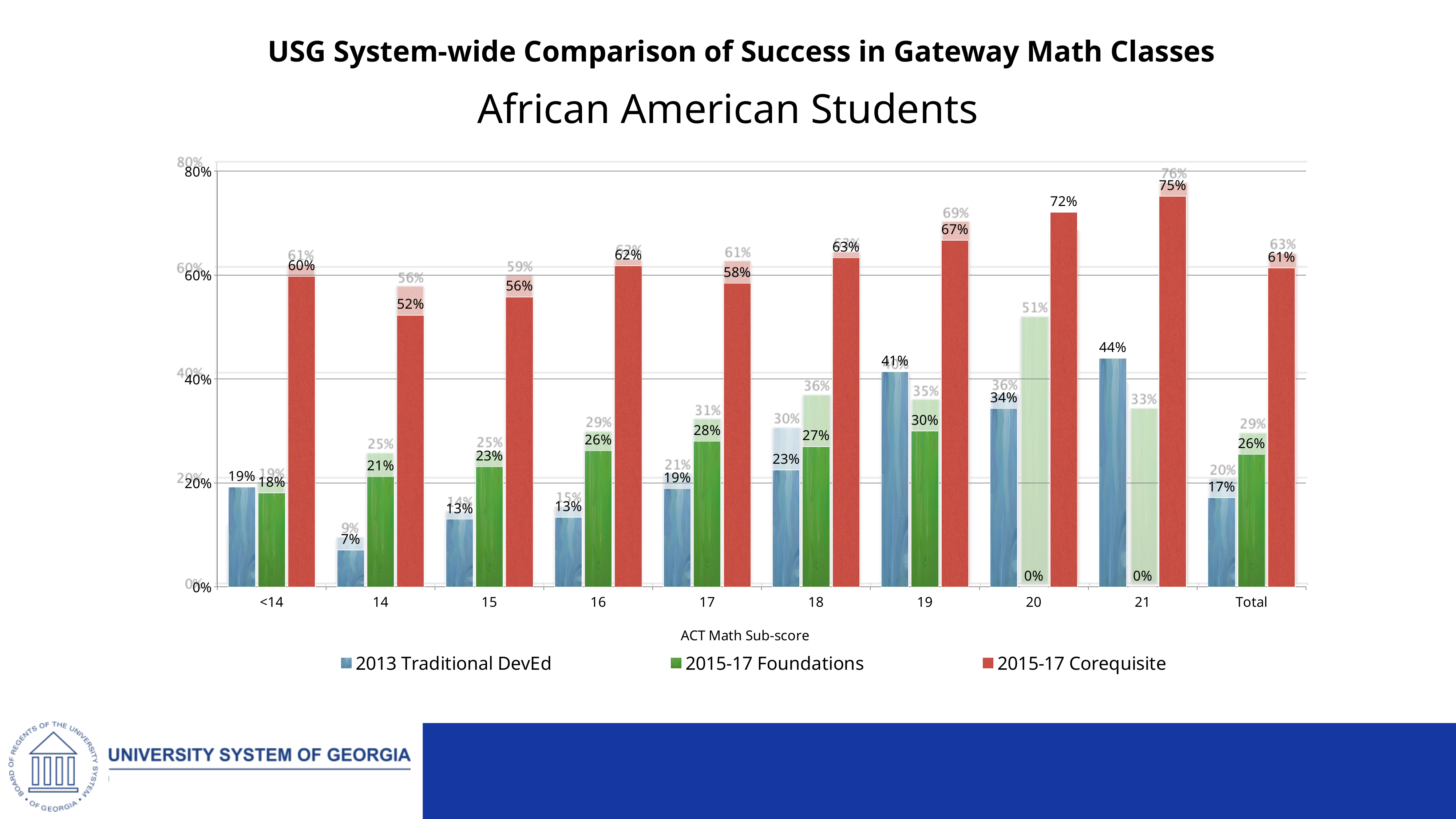
What is the 2015-17 Corequisite success rate for the Total category? 61% What type of chart is shown on the slide? bar chart For ACT Math Sub-score 20, which is larger: the 2013 Traditional DevEd rate or the 2015-17 Corequisite rate? 2015-17 Corequisite What is the 2013 Traditional DevEd success rate for ACT Math Sub-score 14? 7% What is the difference between the 2015-17 Corequisite and 2013 Traditional DevEd success rates for the Total category? 44% Which ACT Math Sub-score category has the highest 2015-17 Corequisite success rate? 21 What is the 2015-17 Foundations success rate for ACT Math Sub-score 17? 28% How many ACT Math Sub-score categories are shown on the x axis? 10 Is the 2015-17 Corequisite value for ACT Math Sub-score 16 greater or less than 60%? greater What is the label of the x axis? ACT Math Sub-score Which ACT Math Sub-score category has the lowest 2013 Traditional DevEd success rate? 14 How many series does the legend list? 3